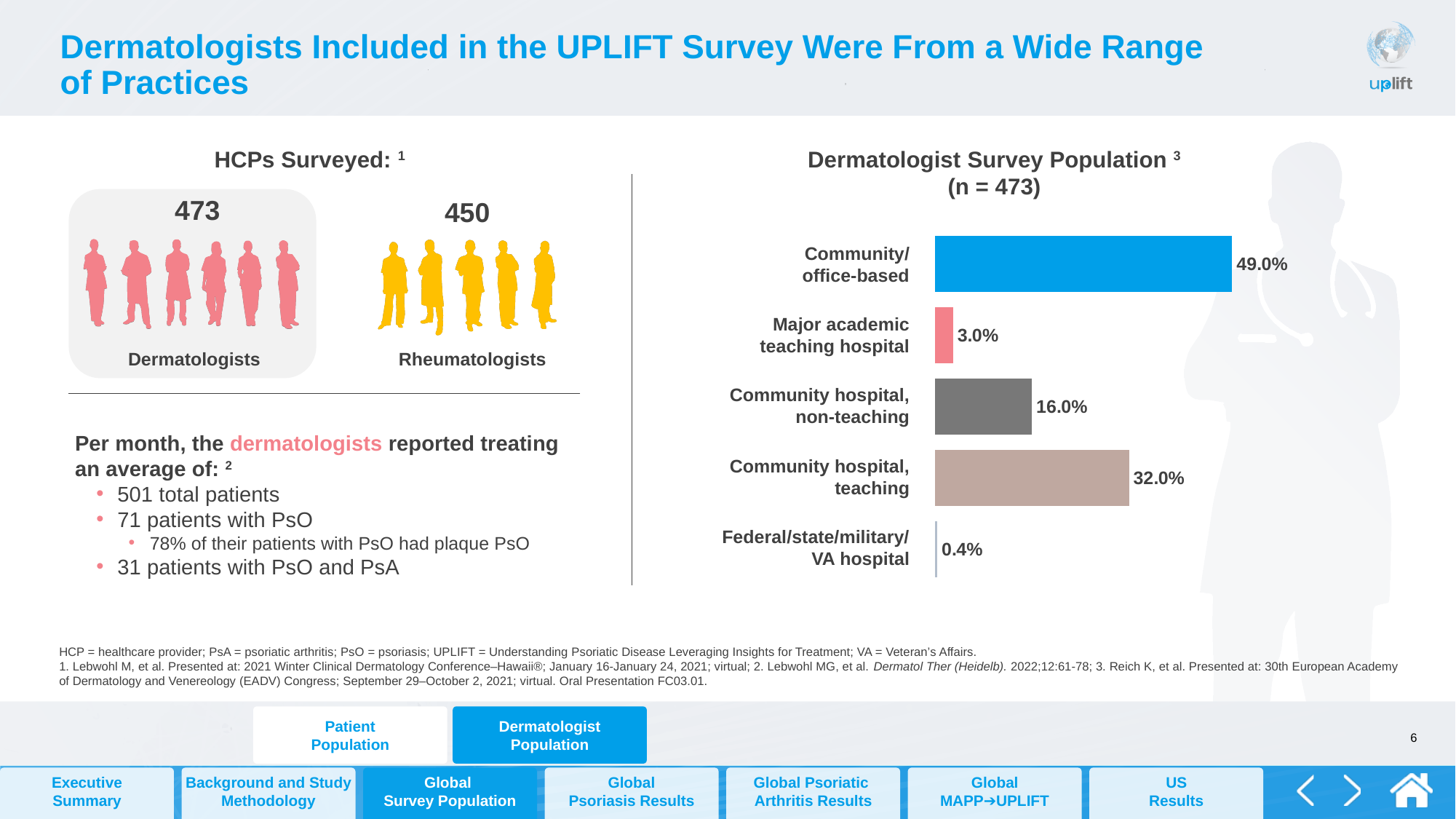
What is the sample size (n) stated in the title of the Dermatologist Survey Population chart? 473 What type of chart is the Dermatologist Survey Population chart? Bar chart In the Dermatologist Survey Population chart, which is larger: Community hospital, teaching or Community hospital, non-teaching? Community hospital, teaching In the Dermatologist Survey Population chart, what is the difference between Community/office-based and Community hospital, teaching? 17.0% In the Dermatologist Survey Population chart, what is the value for Federal/state/military/VA hospital? 0.4% In the Dermatologist Survey Population chart, what is the difference between Community hospital, non-teaching and Major academic teaching hospital? 13.0% In the Dermatologist Survey Population chart, what is the value for Major academic teaching hospital? 3.0% In the Dermatologist Survey Population chart, what is the value for Community hospital, non-teaching? 16.0% In the Dermatologist Survey Population chart, which practice setting has the lowest value? Federal/state/military/VA hospital In the Dermatologist Survey Population chart, what is the value for Community/office-based? 49.0% In the Dermatologist Survey Population chart, which practice setting has the highest value? Community/office-based How many practice setting categories are shown in the Dermatologist Survey Population chart? 5